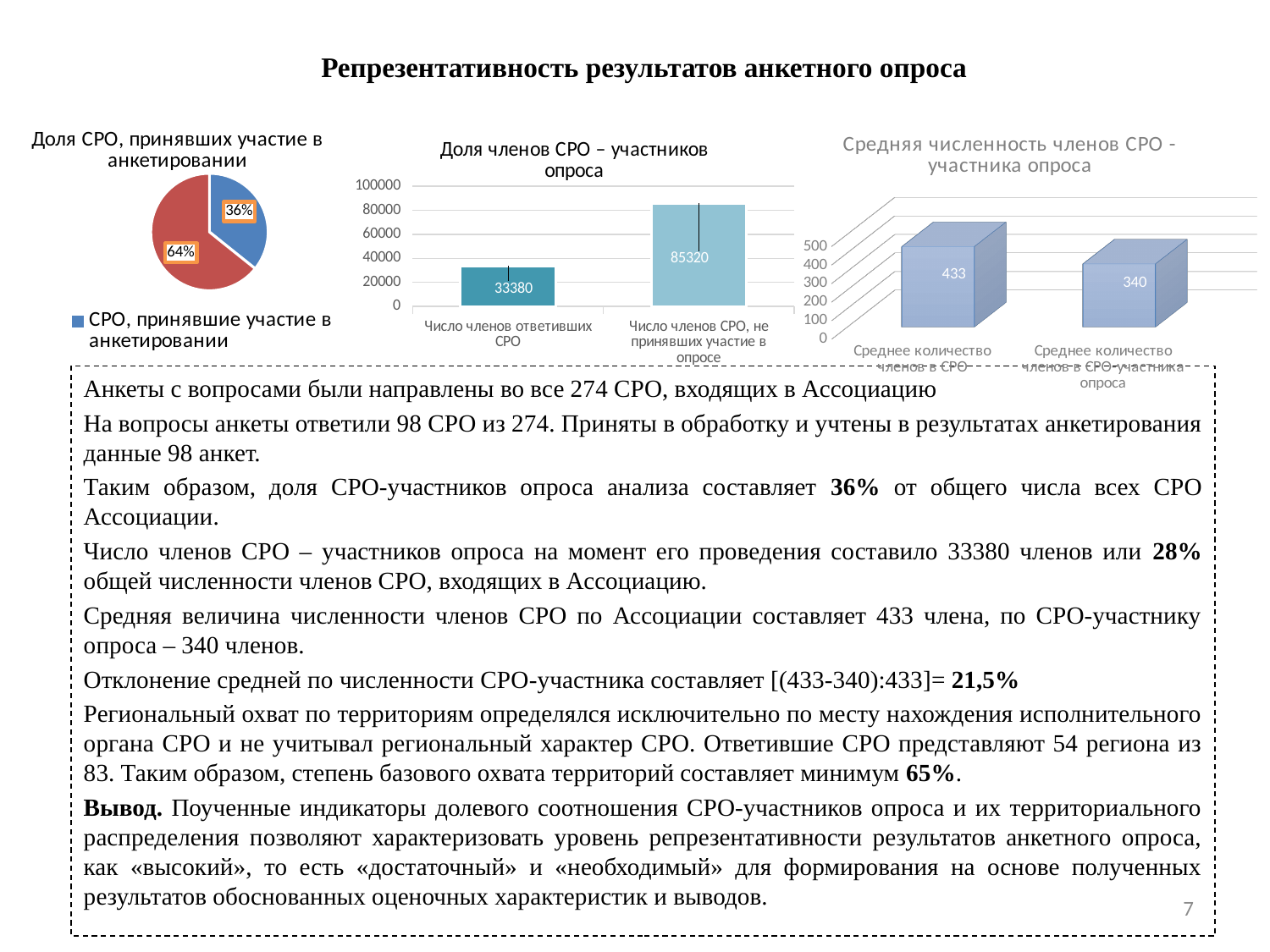
In the chart titled "Средняя численность членов СРО - участника опроса", what is the value for "Среднее количество членов в СРО-участника опроса"? 340 In the pie chart titled "Доля СРО, принявших участие в анкетировании", what share is shown for the blue slice (СРО, принявшие участие в анкетировании)? 36% In the chart titled "Доля членов СРО – участников опроса", what is the value for "Число членов ответивших СРО"? 33380 In the chart titled "Средняя численность членов СРО - участника опроса", what is the value for "Среднее количество членов в СРО"? 433 In the chart titled "Доля членов СРО – участников опроса", which category has the highest value? Число членов СРО, не принявших участие в опросе In the chart titled "Доля членов СРО – участников опроса", what is the difference between the two bars? 51940 How many charts are shown on the slide? 3 In the chart titled "Доля членов СРО – участников опроса", what type of chart is shown? Bar chart In the chart titled "Доля членов СРО – участников опроса", what is the value for "Число членов СРО, не принявших участие в опросе"? 85320 In the chart titled "Средняя численность членов СРО - участника опроса", which category has the lowest value? Среднее количество членов в СРО-участника опроса In the pie chart titled "Доля СРО, принявших участие в анкетировании", what is the value of the larger slice? 64% In the chart titled "Средняя численность членов СРО - участника опроса", what is the difference between the two bars? 93